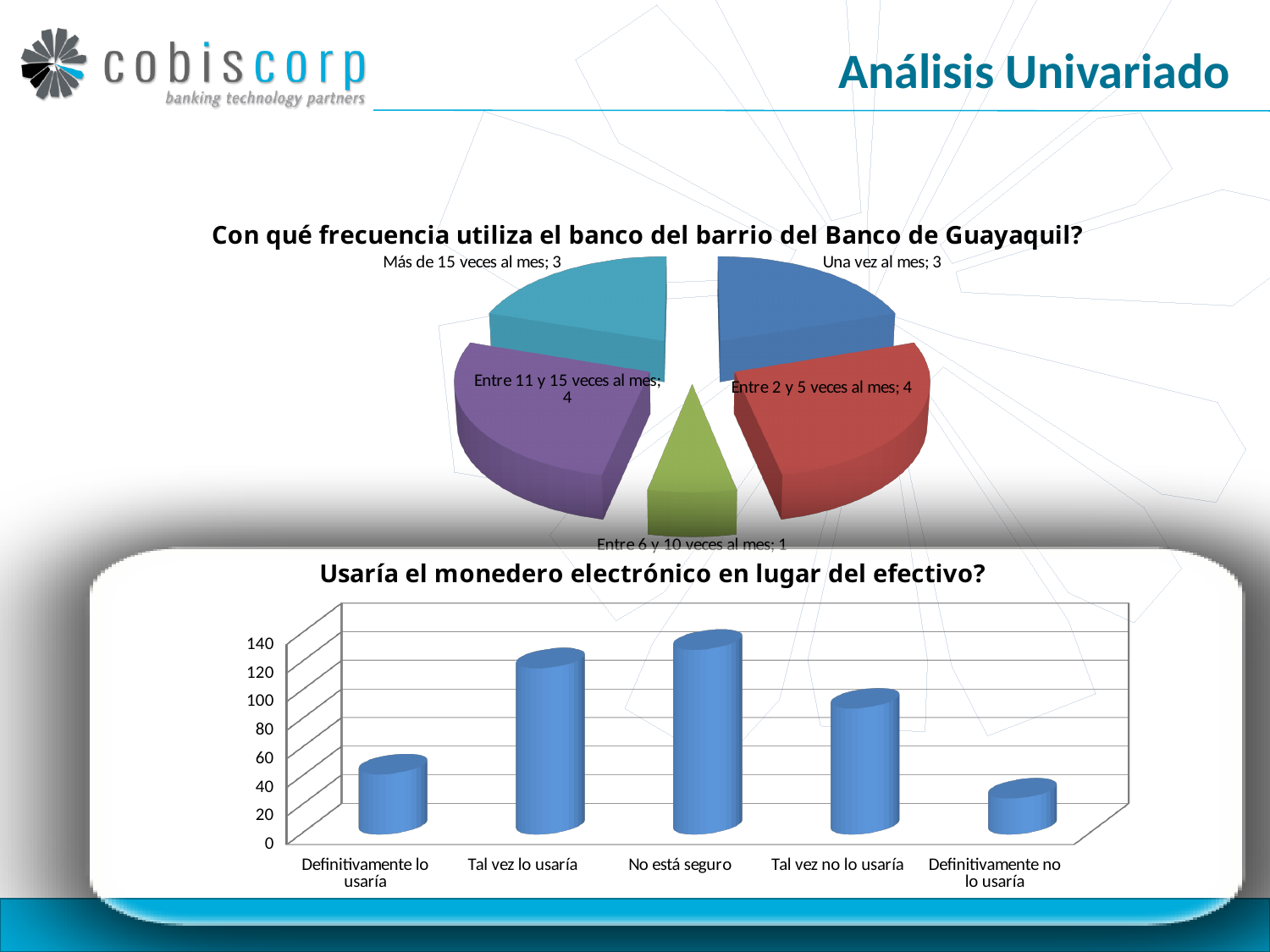
In the chart 'Usaría el monedero electrónico en lugar del efectivo?', which category has the lowest value? Definitivamente no lo usaría In the pie chart 'Con qué frecuencia utiliza el banco del barrio del Banco de Guayaquil?', what is the value for 'Entre 2 y 5 veces al mes'? 4 In the chart 'Usaría el monedero electrónico en lugar del efectivo?', is the value for 'Tal vez lo usaría' greater or less than 100? greater In the chart 'Usaría el monedero electrónico en lugar del efectivo?', which category has the highest value? No está seguro In the pie chart 'Con qué frecuencia utiliza el banco del barrio del Banco de Guayaquil?', what is the value for 'Una vez al mes'? 3 In the pie chart 'Con qué frecuencia utiliza el banco del barrio del Banco de Guayaquil?', which is larger: 'Más de 15 veces al mes' or 'Entre 11 y 15 veces al mes'? Entre 11 y 15 veces al mes In the pie chart 'Con qué frecuencia utiliza el banco del barrio del Banco de Guayaquil?', how many slices are there? 5 In the pie chart 'Con qué frecuencia utiliza el banco del barrio del Banco de Guayaquil?', what is the difference between 'Entre 11 y 15 veces al mes' and 'Entre 6 y 10 veces al mes'? 3 In the chart 'Usaría el monedero electrónico en lugar del efectivo?', how many categories are shown on the x axis? 5 What kind of chart is 'Usaría el monedero electrónico en lugar del efectivo?'? bar chart In the pie chart 'Con qué frecuencia utiliza el banco del barrio del Banco de Guayaquil?', which category has the smallest value? Entre 6 y 10 veces al mes In the chart 'Usaría el monedero electrónico en lugar del efectivo?', is the value for 'Definitivamente lo usaría' greater or less than 60? less